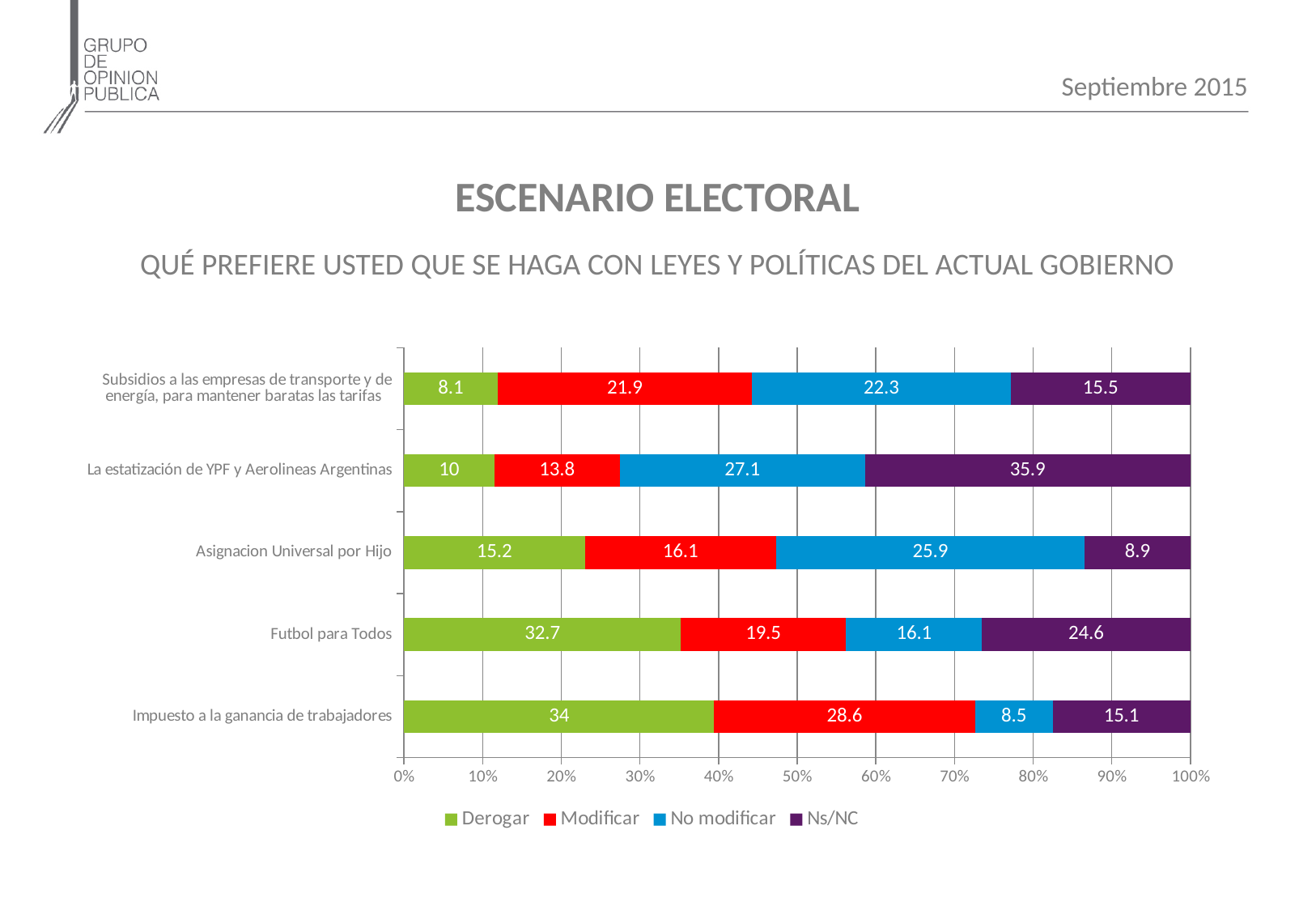
Which is larger for Futbol para Todos: the Modificar value or the Ns/NC value? Ns/NC What is the difference between the Modificar value and the No modificar value for Impuesto a la ganancia de trabajadores? 20.1 Which category has the highest Derogar value? Impuesto a la ganancia de trabajadores How many series does the legend list? 4 Which category has the highest Ns/NC value? La estatización de YPF y Aerolineas Argentinas What is the Modificar value for Subsidios a las empresas de transporte y de energía, para mantener baratas las tarifas? 21.9 What is the Derogar value for Futbol para Todos? 32.7 What kind of chart is shown on the slide? Stacked bar chart What is the Ns/NC value for La estatización de YPF y Aerolineas Argentinas? 35.9 How many categories are shown on the chart? 5 Which category has the lowest No modificar value? Impuesto a la ganancia de trabajadores What is the No modificar value for Asignacion Universal por Hijo? 25.9